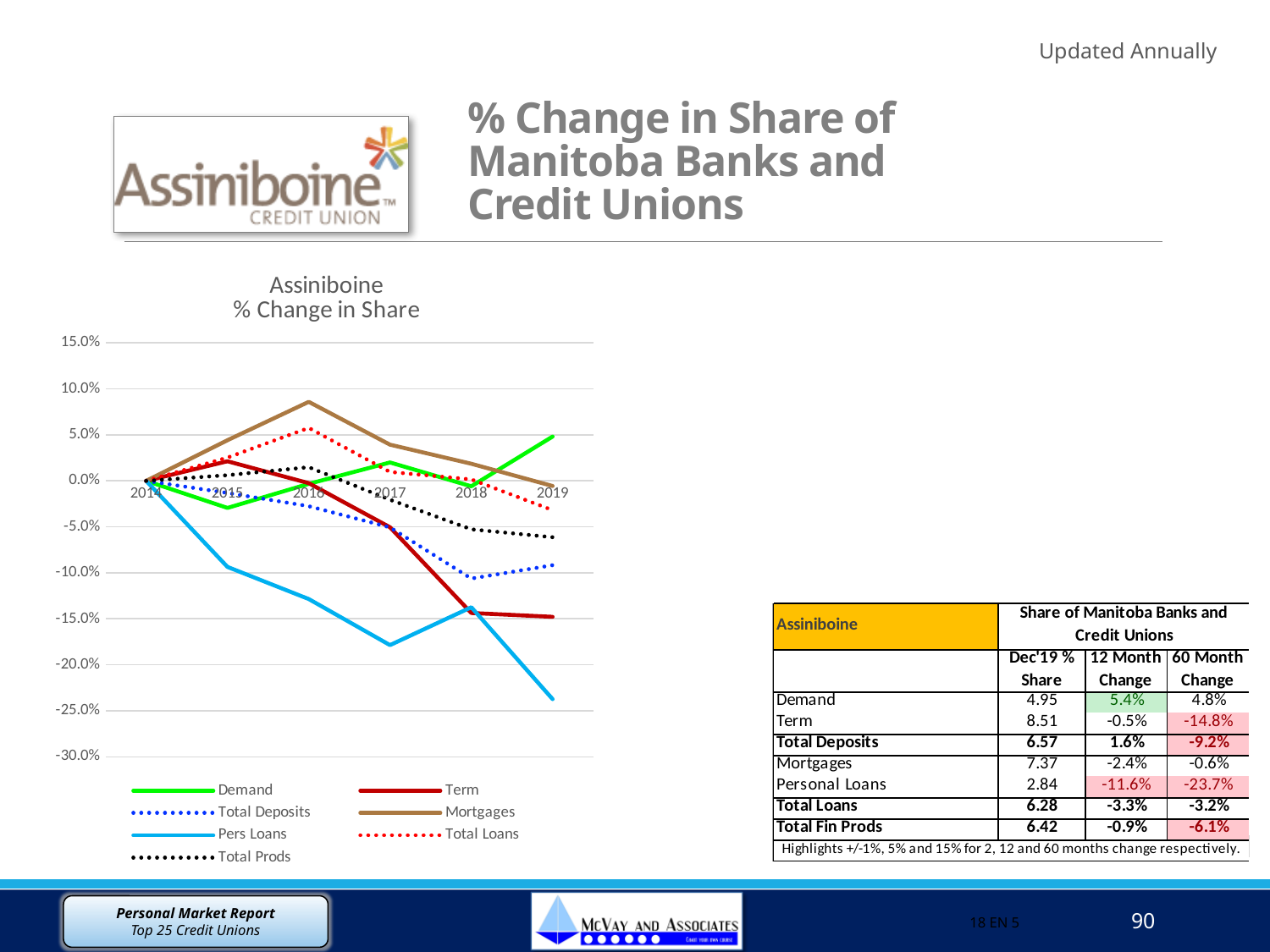
What kind of chart is shown on the slide? line chart Does the Pers Loans line rise or fall overall from 2014 to 2019? fall Is the value for Term in 2019 greater or less than -10.0%? less How many series does the legend of the chart list? 7 Which series has the highest value in 2016? Mortgages How many years are plotted along the x axis of the chart? 6 Is the value for Pers Loans in 2019 greater or less than -20.0%? less Is the value for Mortgages in 2016 greater or less than 5.0%? greater What is the title of the chart? Assiniboine % Change in Share In 2019, which is higher: Demand or Term? Demand Which series has the lowest value in 2019? Pers Loans